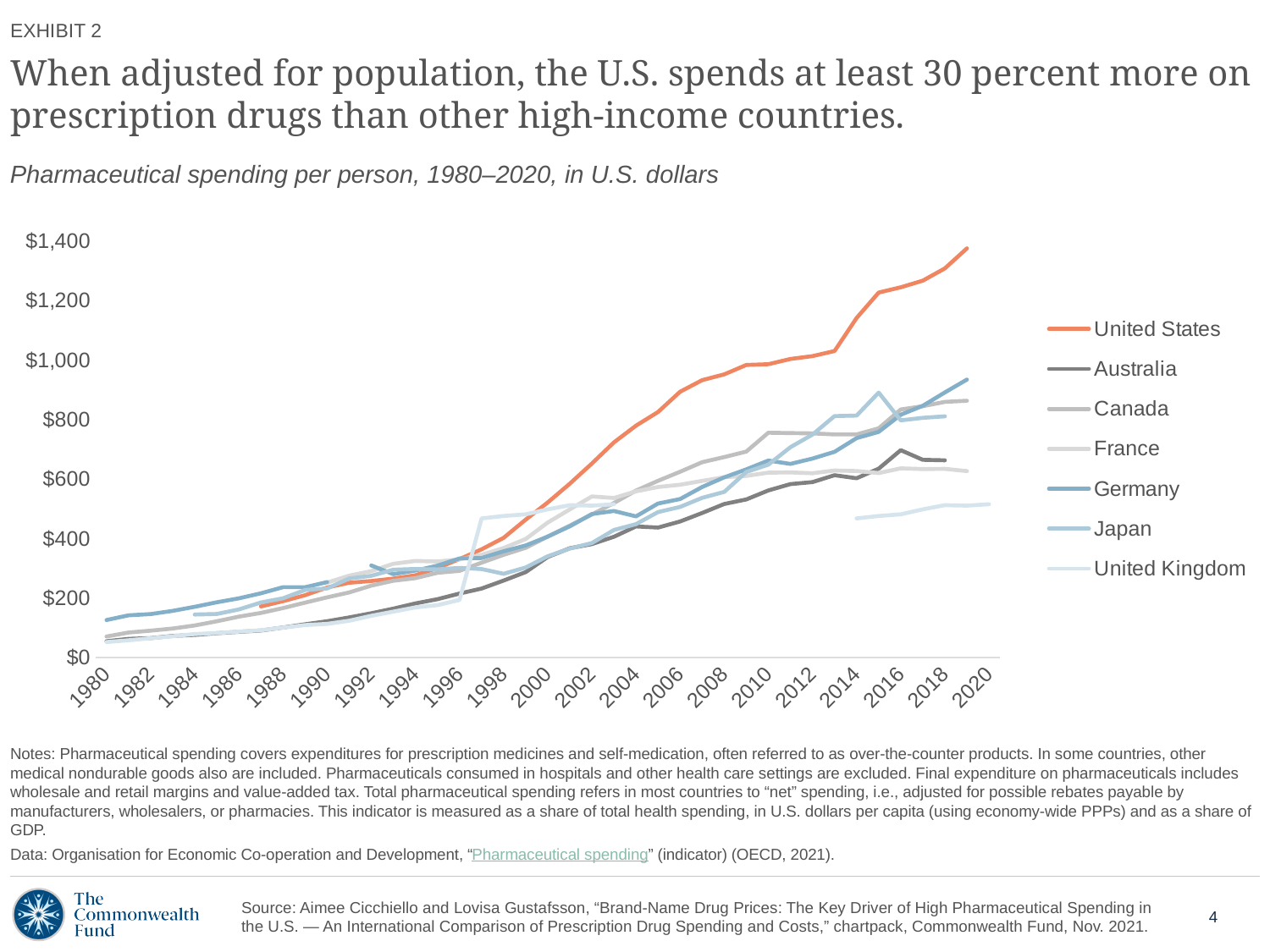
Is the value for the United Kingdom in 2020 greater or less than $600? less Is the value for the United States in 1990 greater or less than $400? less Which country has the lowest pharmaceutical spending per person in 2020? United Kingdom What kind of chart is shown on the slide? line chart How many series does the legend list? 7 Does the United States line rise or fall from 1980 to 2020? rise What colour is the United States line in the chart? orange